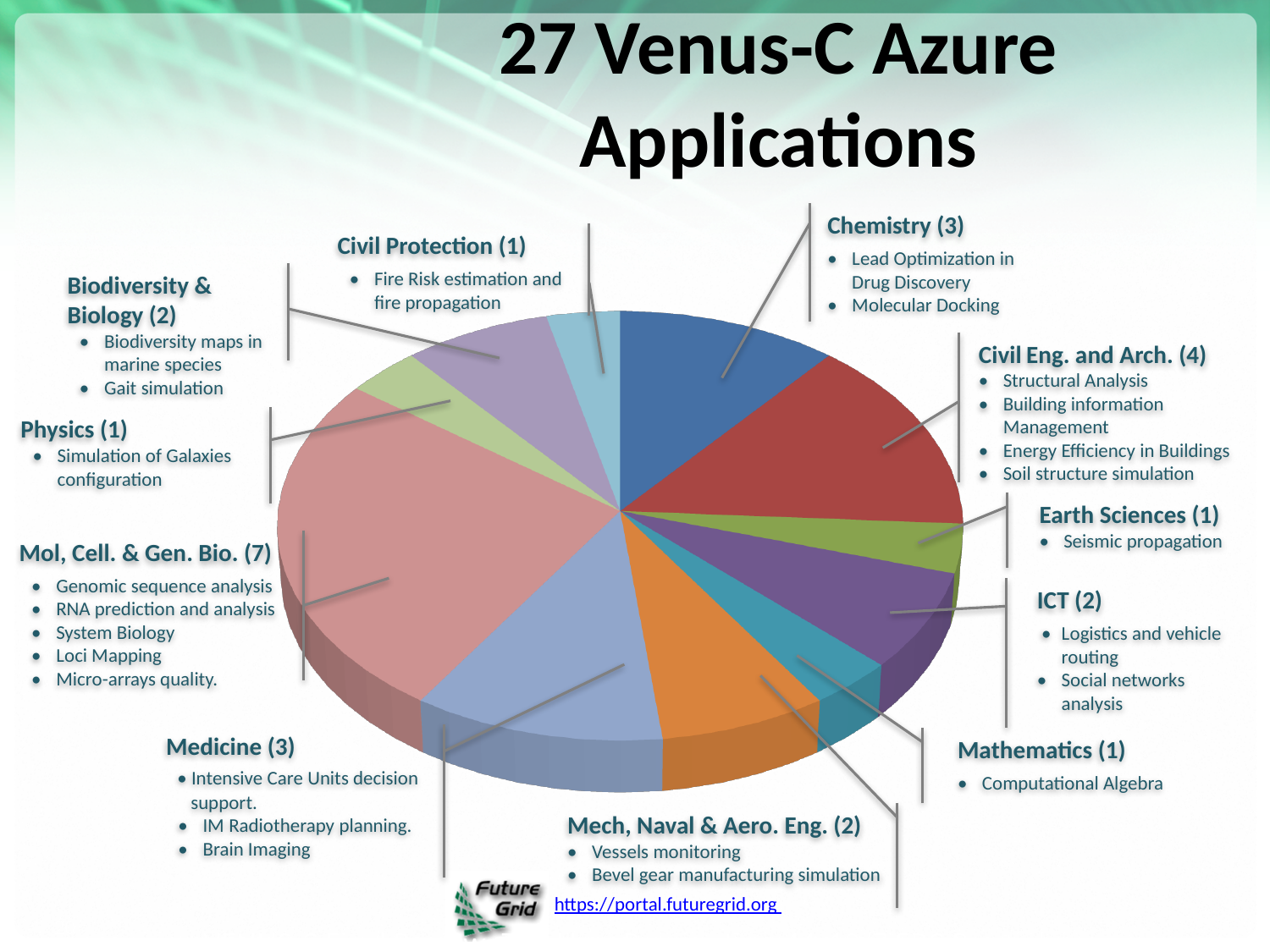
How many applications are in the ICT category? 2 Which has more applications, Medicine or Mathematics? Medicine How many applications are in the Mol, Cell. & Gen. Bio. category? 7 What is the difference between the number of applications in Mol, Cell. & Gen. Bio. and in Civil Eng. and Arch.? 3 How many application categories (slices) does the pie chart show? 11 What kind of chart is shown on the slide? pie chart What is the title of the chart on the slide? 27 Venus-C Azure Applications Which category has the largest number of applications? Mol, Cell. & Gen. Bio. How many applications are in the Civil Eng. and Arch. category? 4 What is the total number of applications across all categories in the pie chart? 27 What is the difference between the number of applications in Civil Eng. and Arch. and in Earth Sciences? 3 How many applications are in the Chemistry category? 3